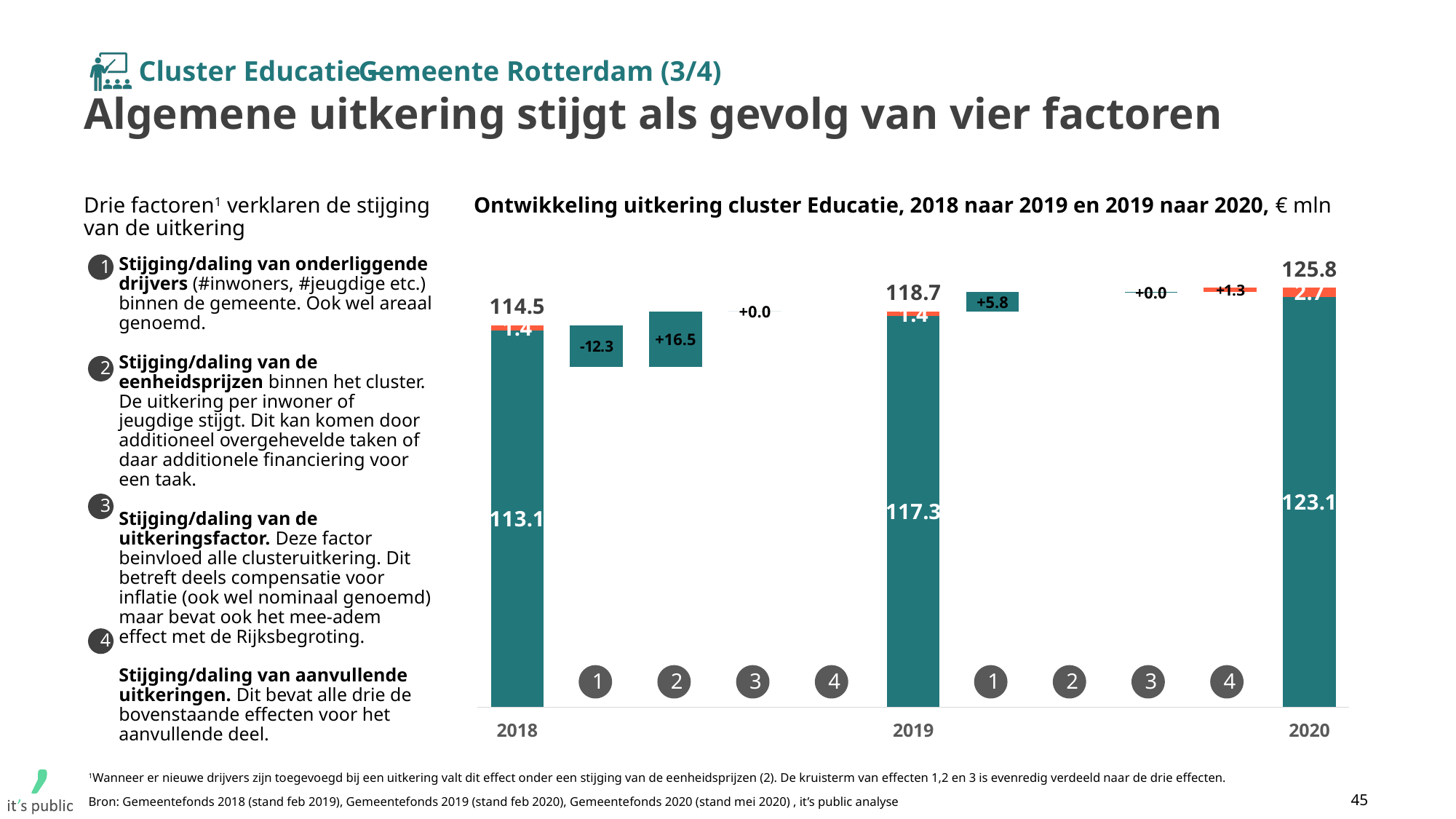
Which year has the higher total uitkering, 2018 or 2019? 2019 What is the value of factor 1 in the change from 2018 to 2019? -12.3 What is the total uitkering value shown for 2018? 114.5 What is the value of factor 2 in the change from 2018 to 2019? +16.5 What is the total uitkering value shown for 2020? 125.8 Do the year totals rise or fall from 2018 to 2020? rise What kind of chart is shown on the slide? bar chart What is the value of factor 1 in the change from 2019 to 2020? +5.8 By how much does the total uitkering in 2020 exceed the total in 2018? 11.3 What is the value of the large teal segment of the 2019 bar? 117.3 What is the value of the orange top segment of the 2020 bar? 2.7 What is the value of factor 4 in the change from 2019 to 2020? +1.3